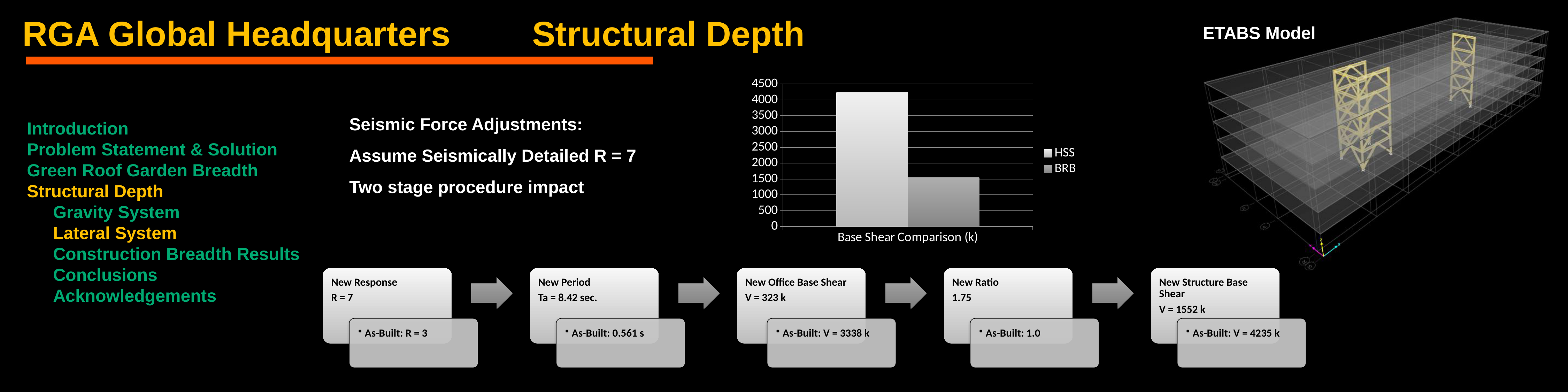
Is the value for HSS greater or less than 4500? less Which series has the taller bar in the Base Shear Comparison chart? HSS What is the highest tick value shown on the chart's vertical axis? 4500 How many series does the chart legend list? 2 Is the value for BRB greater or less than 1000? greater Is the value for BRB greater or less than 2000? less What is the label shown beneath the bars of the chart? Base Shear Comparison (k) Is the base shear for HSS larger or smaller than the base shear for BRB? larger Which series has the shorter bar in the Base Shear Comparison chart? BRB What kind of chart is shown on the slide? bar chart How many bars are plotted in the chart? 2